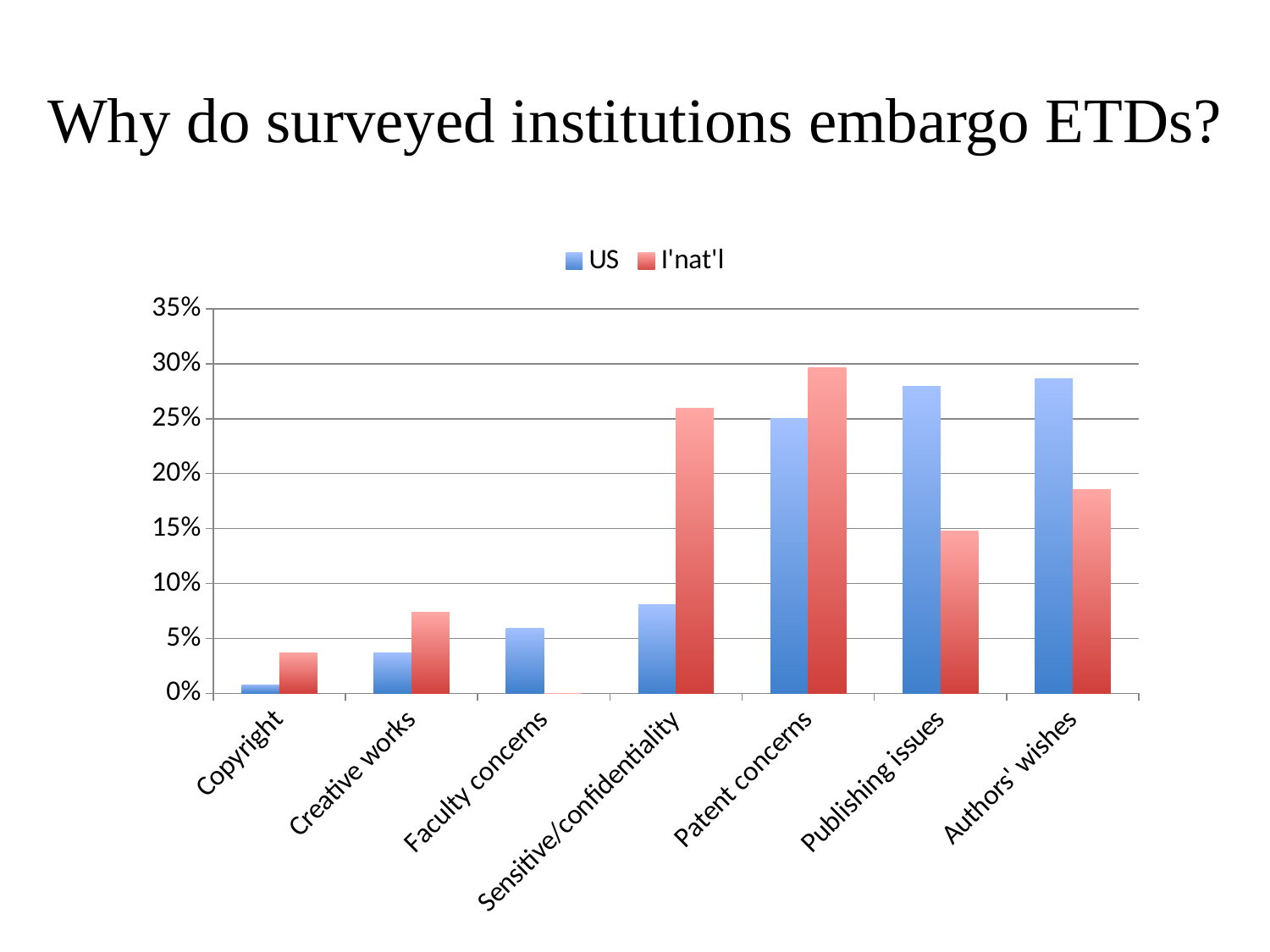
What kind of chart is shown on the slide? bar chart Which category has the highest I'nat'l value? Patent concerns Which category has the lowest US value? Copyright Which category has no I'nat'l bar shown? Faculty concerns For Publishing issues, which series has the larger value, US or I'nat'l? US Is the US value for Patent concerns greater or less than 20%? greater Is the I'nat'l value for Sensitive/confidentiality greater or less than 25%? greater For Sensitive/confidentiality, which series has the larger value, US or I'nat'l? I'nat'l How many series does the legend list? 2 How many categories are shown on the x axis? 7 Is the US value for Copyright greater or less than 5%? less